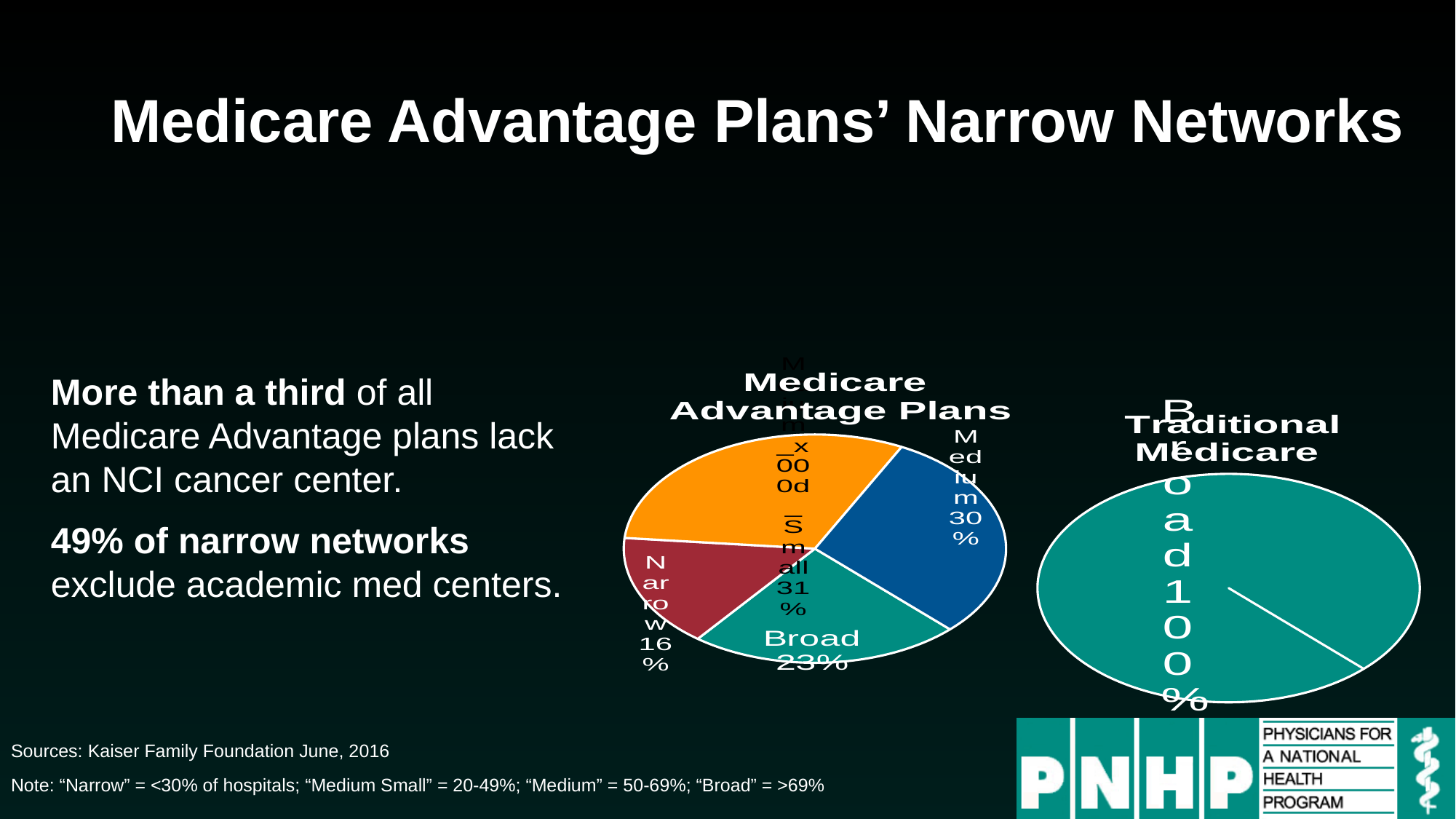
In the "Medicare Advantage Plans" chart, what is the difference between the Broad share and the Narrow share? 7% In the "Medicare Advantage Plans" chart, what is the difference between the Medium share and the Broad share? 7% In the "Medicare Advantage Plans" chart, how many slices does the pie have? 4 In the "Medicare Advantage Plans" chart, what share of plans have Broad networks? 23% In the "Medicare Advantage Plans" chart, which is larger: the Broad share or the Narrow share? Broad In the "Medicare Advantage Plans" chart, which network category has the smallest share? Narrow In the "Medicare Advantage Plans" chart, what share of plans have Narrow networks? 16% In the "Medicare Advantage Plans" chart, what share of plans have Medium networks? 30% In the "Traditional Medicare" chart, how many network categories are shown? 1 In the "Traditional Medicare" chart, what share is labelled Broad? 100% What kind of chart is the "Medicare Advantage Plans" chart? Pie chart In the "Medicare Advantage Plans" chart, what colour is the Narrow slice? Red